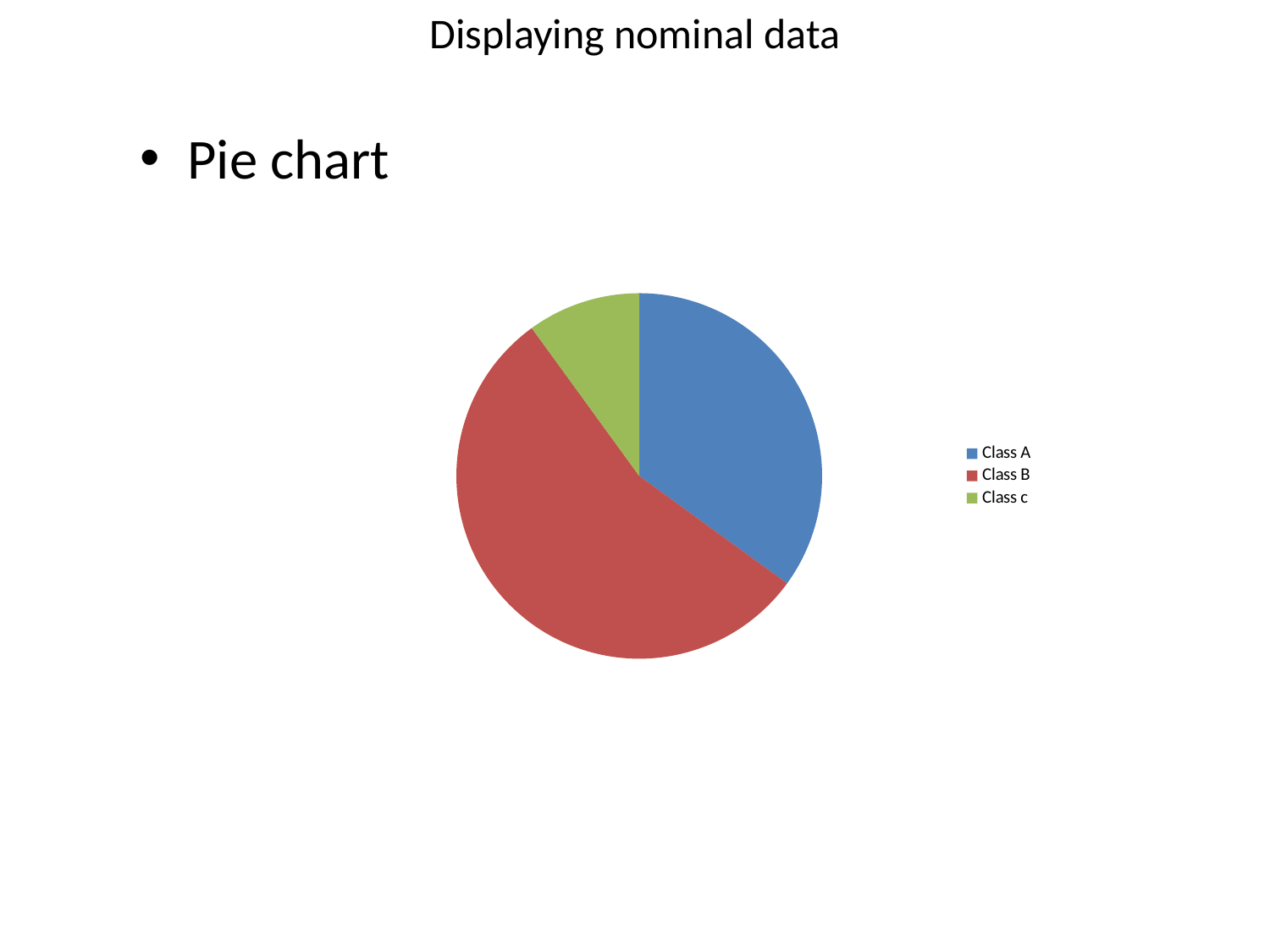
Which category has the smallest slice in the pie chart? Class c Which slice is larger in the pie chart, Class B or Class c? Class B What colour is the Class B slice in the pie chart? Red Which slice is larger in the pie chart, Class A or Class B? Class B Which category has the largest slice in the pie chart? Class B How many entries does the legend of the pie chart list? 3 Which slice is larger in the pie chart, Class A or Class c? Class A Which category is shown in green in the pie chart? Class c What kind of chart is shown on the slide? Pie chart How many slices does the pie chart have? 3